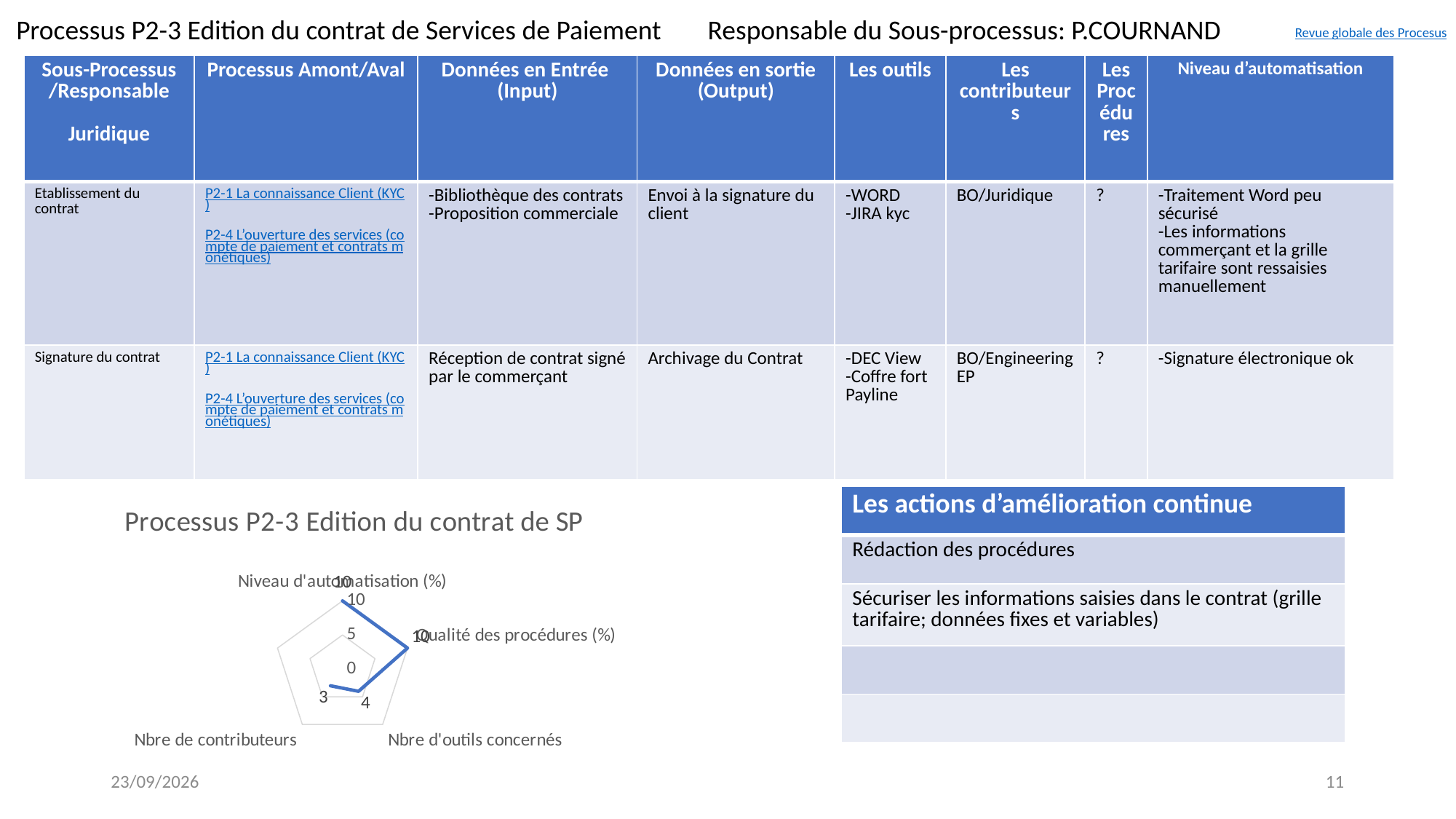
What is the value for Nbre de contributeurs in the chart? 3 Which is larger: the value for Qualité des procédures (%) or the value for Nbre d'outils concernés? Qualité des procédures (%) What is the value for Nbre d'outils concernés in the chart? 4 What is the title of the chart on the slide? Processus P2-3 Edition du contrat de SP Is the value for Nbre de contributeurs greater or less than 5? less What is the value for Niveau d'automatisation (%) in the chart? 10 What is the highest tick value shown on the chart's scale? 10 What kind of chart is shown on the slide? radar chart What is the difference between the values for Nbre d'outils concernés and Nbre de contributeurs? 1 Which labelled axis has the lowest value in the chart? Nbre de contributeurs What is the value for Qualité des procédures (%) in the chart? 10 Is the value for Niveau d'automatisation (%) greater or less than 5? greater